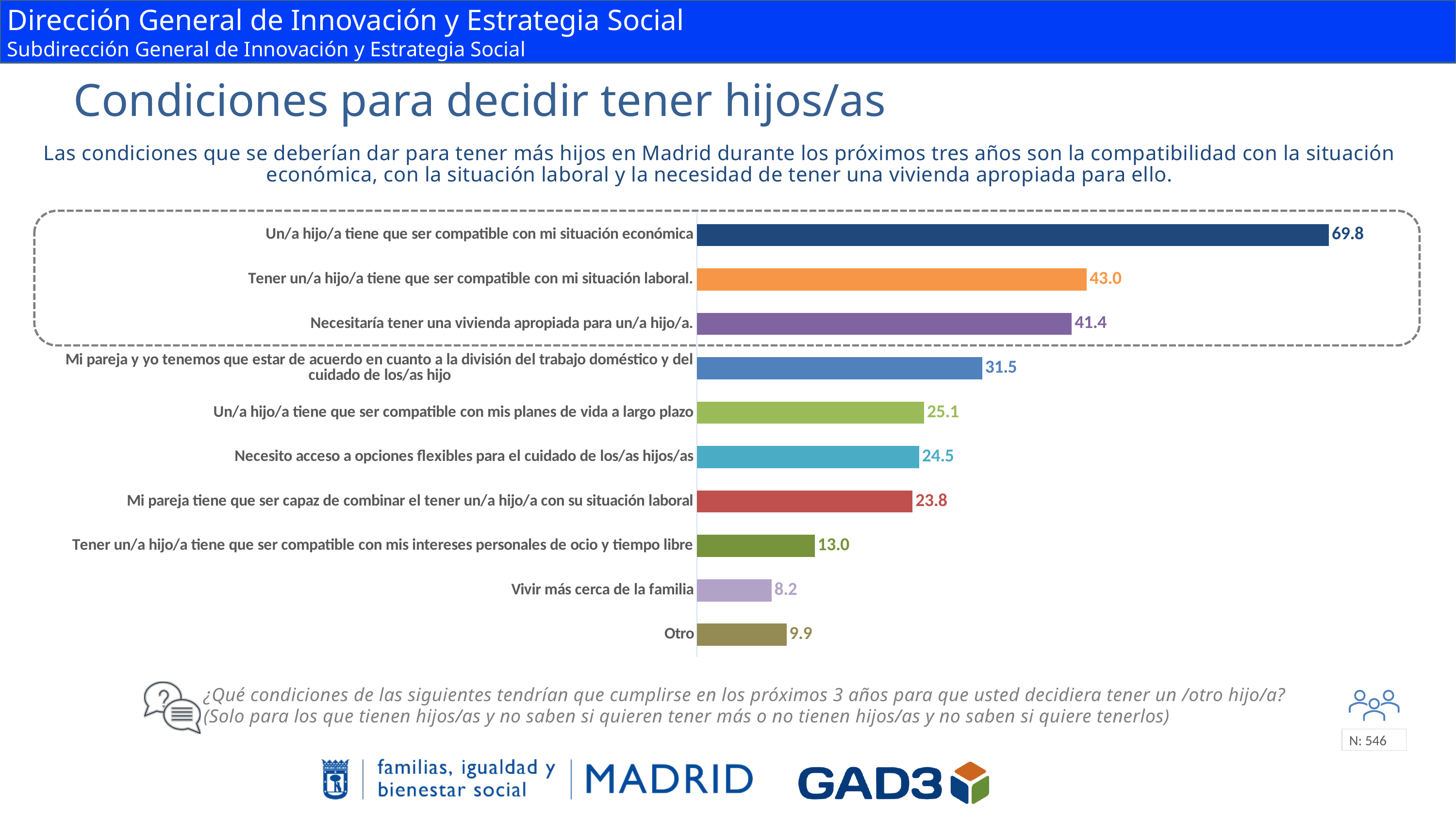
How many categories does the chart show? 10 What is the difference between the values for "Tener un/a hijo/a tiene que ser compatible con mi situación laboral." and "Necesitaría tener una vivienda apropiada para un/a hijo/a."? 1.6 Which category has the highest value? Un/a hijo/a tiene que ser compatible con mi situación económica What is the value for "Otro"? 9.9 What kind of chart is shown on the slide? Bar chart How many categories are enclosed in the dashed box at the top of the chart? 3 Which is larger: the value for "Un/a hijo/a tiene que ser compatible con mis planes de vida a largo plazo" or for "Mi pareja tiene que ser capaz de combinar el tener un/a hijo/a con su situación laboral"? Un/a hijo/a tiene que ser compatible con mis planes de vida a largo plazo Which category has the lowest value? Vivir más cerca de la familia What is the difference between the values for "Un/a hijo/a tiene que ser compatible con mi situación económica" and "Otro"? 59.9 What is the value for "Necesitaría tener una vivienda apropiada para un/a hijo/a."? 41.4 What is the value for "Un/a hijo/a tiene que ser compatible con mi situación económica"? 69.8 What is the value for "Vivir más cerca de la familia"? 8.2